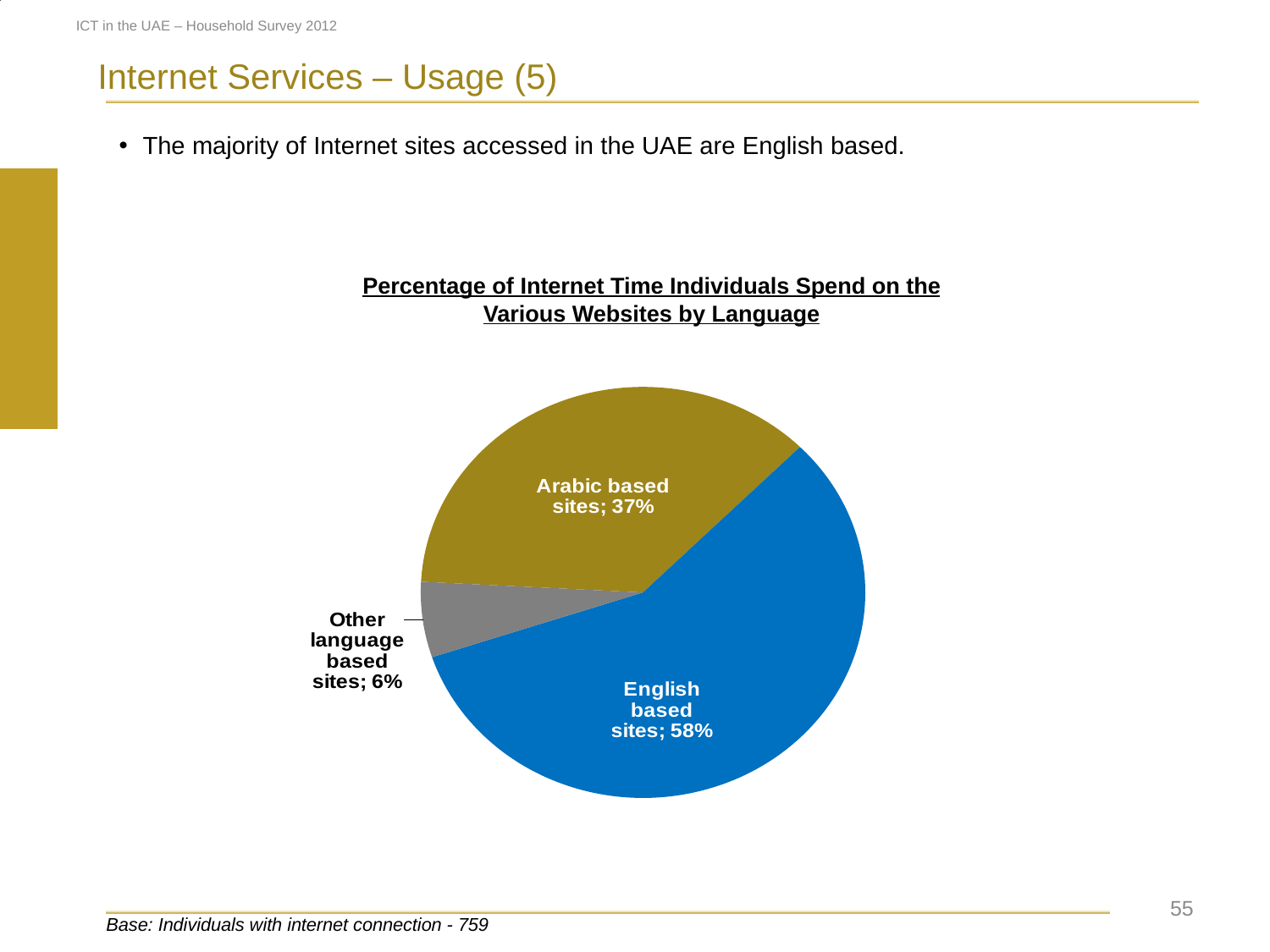
What percentage of Internet time is spent on English based sites? 58% What is the difference in percentage points between Arabic based sites and other language based sites? 31 What is the title of the chart? Percentage of Internet Time Individuals Spend on the Various Websites by Language What percentage of Internet time is spent on other language based sites? 6% Which category has the largest share of Internet time? English based sites What percentage of Internet time is spent on Arabic based sites? 37% What is the difference in percentage points between English based sites and Arabic based sites? 21 What colour is the slice for English based sites? Blue Which category has the smallest share of Internet time? Other language based sites What kind of chart is shown on the slide? Pie chart Which has a larger share: Arabic based sites or other language based sites? Arabic based sites How many categories are shown in the pie chart? 3